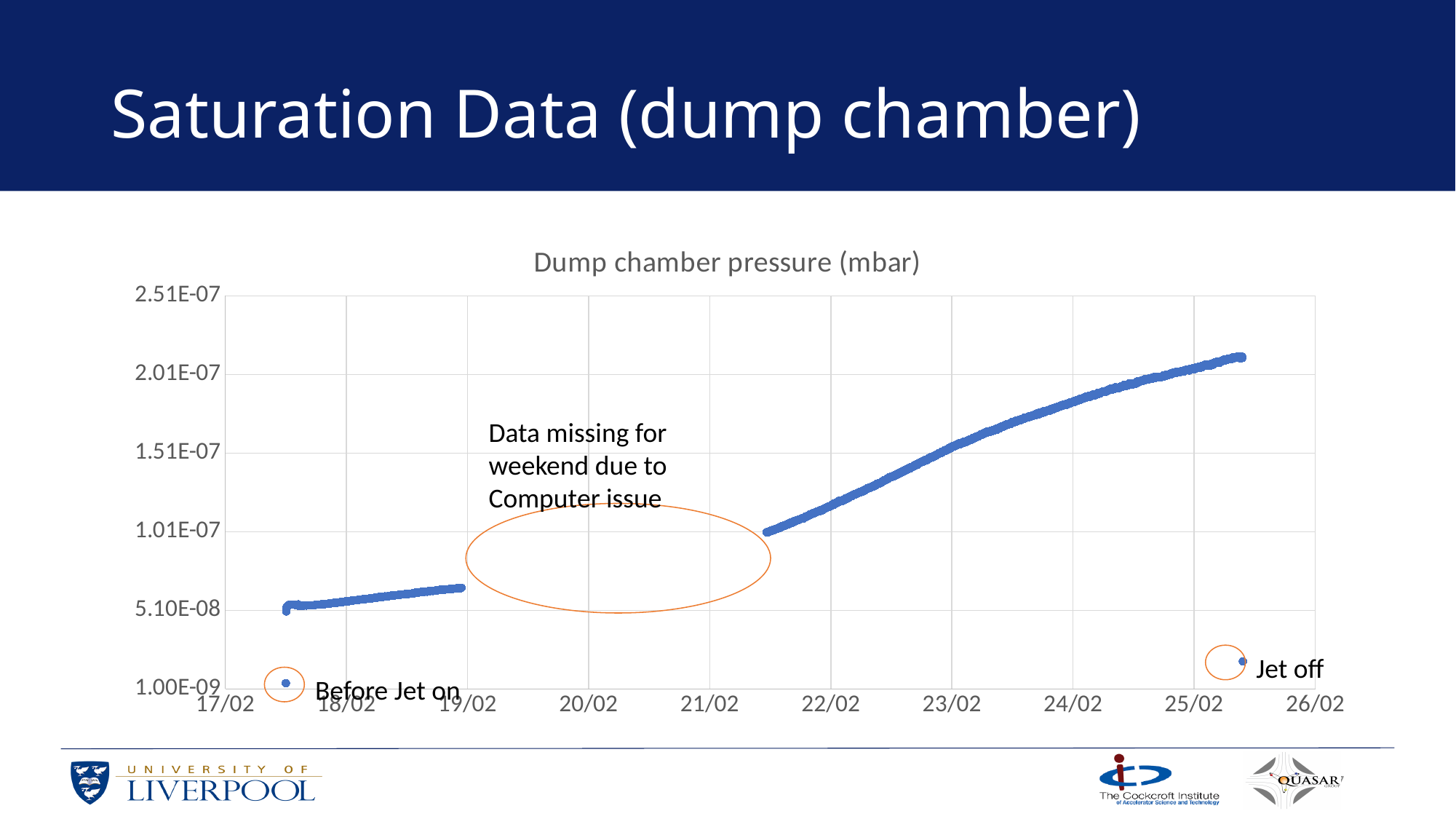
Which date has the higher dump chamber pressure, 18/02 or 24/02? 24/02 What is the highest value shown on the y axis? 2.51E-07 Is the dump chamber pressure on 24/02 greater or less than 1.51E-07? greater Do the plotted pressure values generally rise or fall from 17/02 to 26/02? rise What is the title of the chart? Dump chamber pressure (mbar) What kind of chart is shown on the slide? scatter chart Is the 'Before Jet on' point greater or less than 5.10E-08? less Is the dump chamber pressure on 18/02 greater or less than 1.01E-07? less According to the annotation, why is data missing for the weekend? Computer issue How many date labels are shown on the x axis? 10